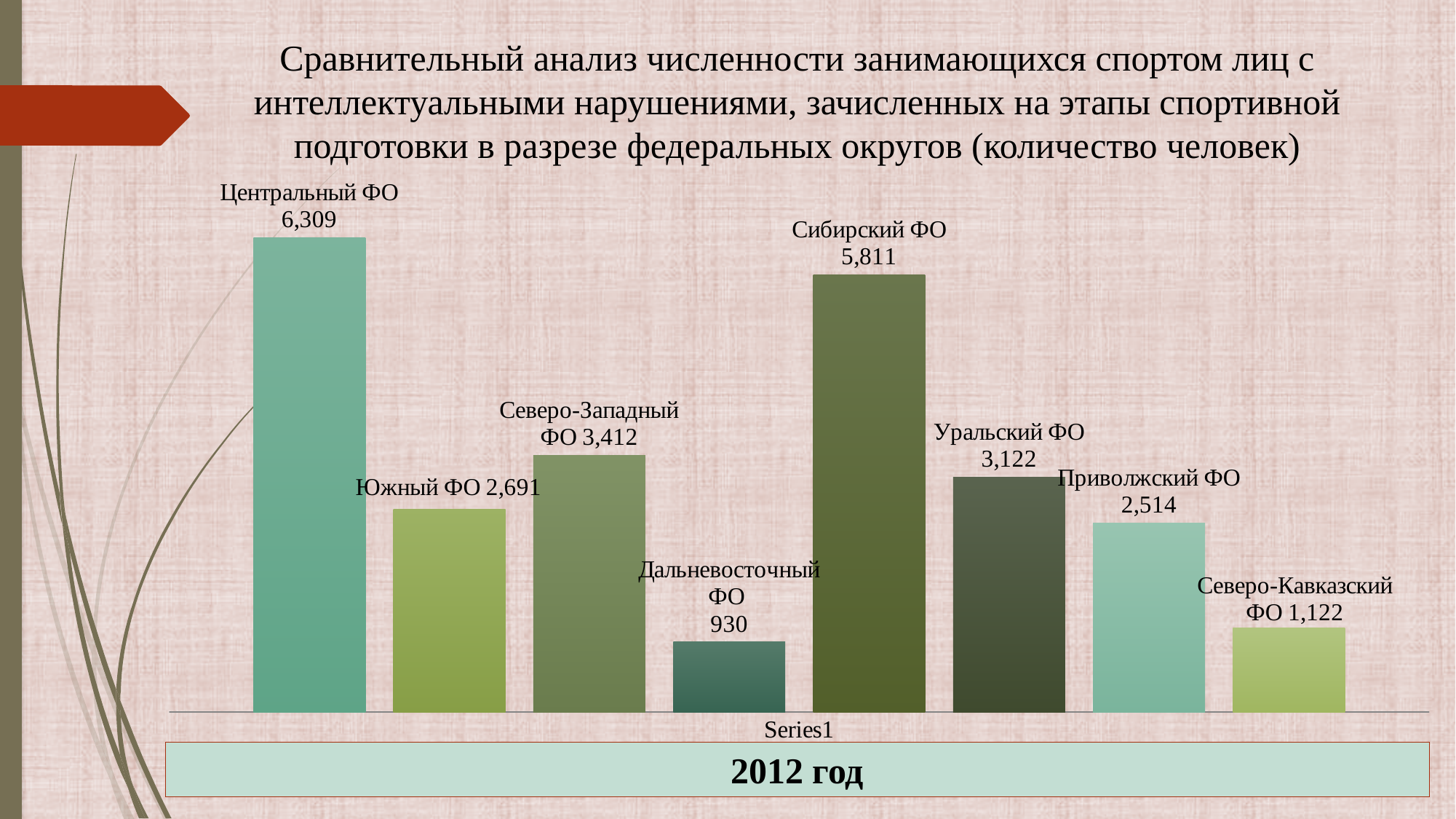
What year is indicated in the box below the chart? 2012 год What is the value shown for Уральский ФО? 3,122 What is the value shown for Северо-Кавказский ФО? 1,122 What kind of chart is shown on the slide? Bar chart Which has a larger value, Уральский ФО or Приволжский ФО? Уральский ФО How many federal districts (bars) are shown on the chart? 8 What is the value shown for Центральный ФО? 6,309 What is the difference between the values for Северо-Западный ФО and Южный ФО? 721 Which federal district has the highest value on the chart? Центральный ФО What is the difference between the values for Центральный ФО and Сибирский ФО? 498 What is the value shown for Дальневосточный ФО? 930 Which federal district has the lowest value on the chart? Дальневосточный ФО